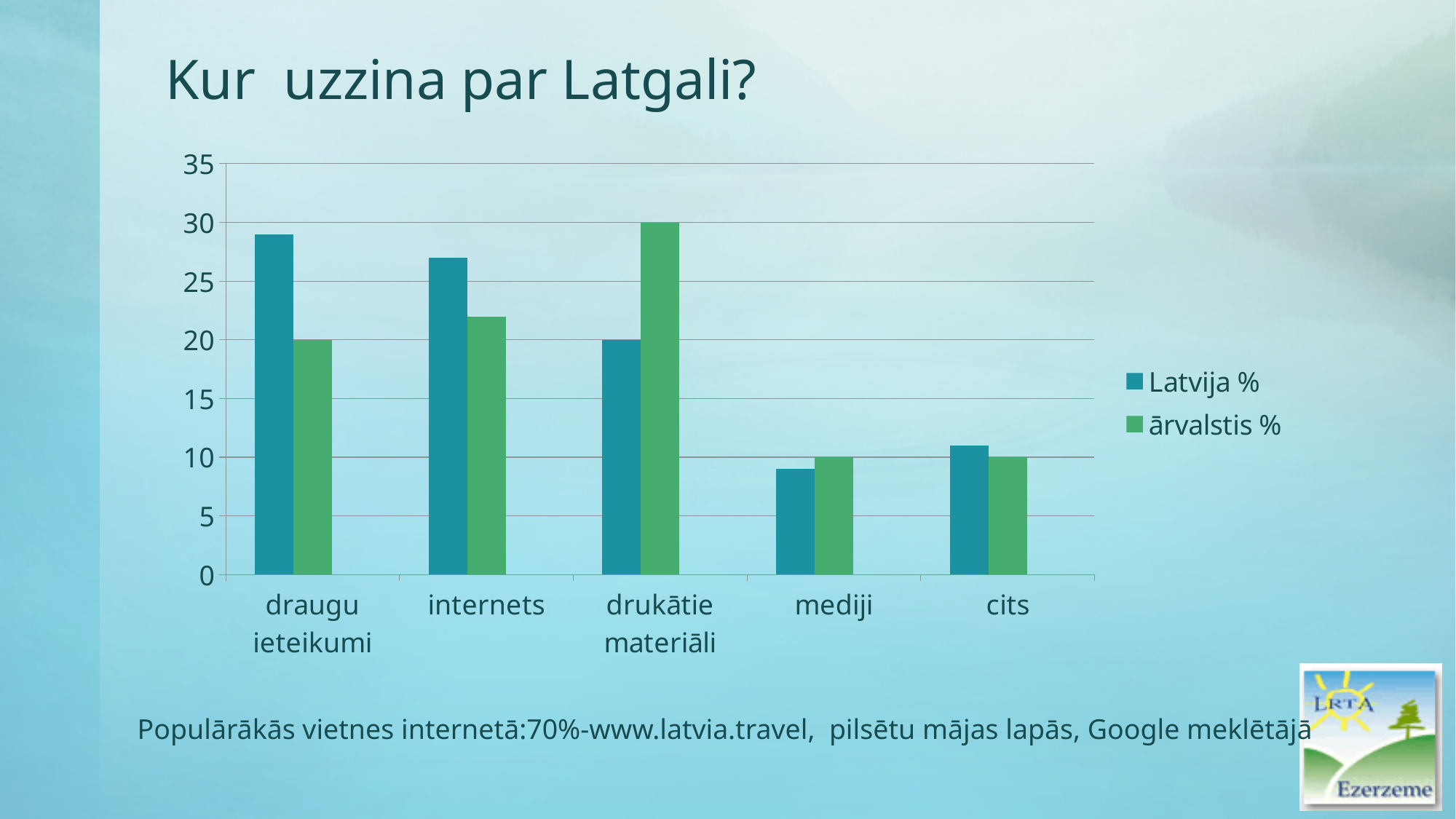
What is the Latvija % value for drukātie materiāli? 20 What is the ārvalstis % value for drukātie materiāli? 30 What is the ārvalstis % value for mediji? 10 How many series does the legend list? 2 How many categories are shown on the x axis? 5 For drukātie materiāli, what is the difference between the ārvalstis % and Latvija % values? 10 Which category has the highest ārvalstis % value? drukātie materiāli Which category has the highest Latvija % value? draugu ieteikumi Which category has the lowest Latvija % value? mediji What is the ārvalstis % value for draugu ieteikumi? 20 What kind of chart is shown on the slide? bar chart Is the Latvija % value for internets greater or less than 25? greater